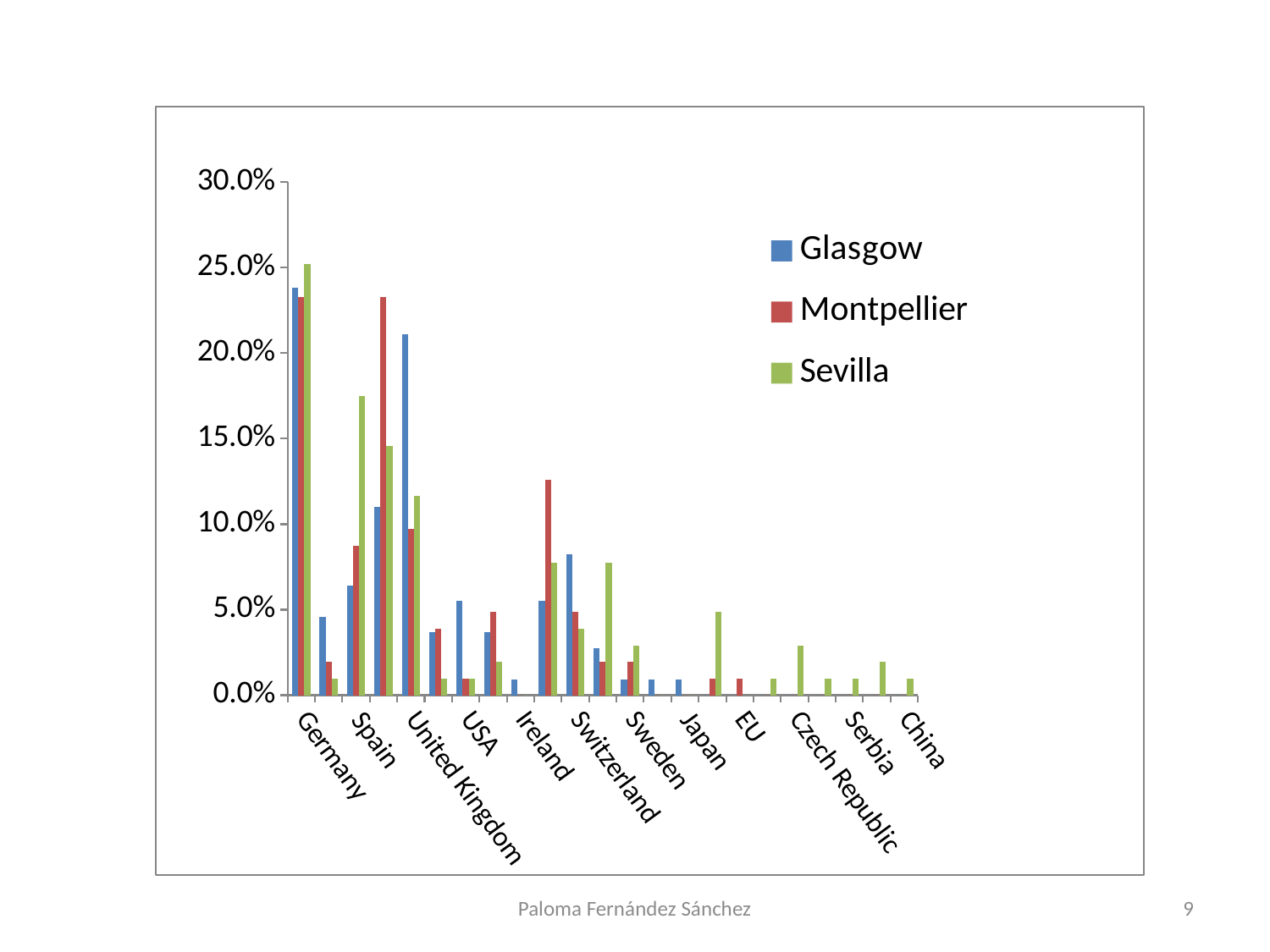
Is the Montpellier value for Germany greater or less than 20.0%? greater Which colour represents the Sevilla series? green For United Kingdom, which is larger: the Glasgow value or the Montpellier value? Glasgow Which country has the highest Sevilla value? Germany Is the Sevilla value for Spain greater or less than 15.0%? greater Is the Glasgow value for Germany greater or less than 25.0%? less For Switzerland, which series has the highest value? Glasgow What kind of chart is shown on the slide? bar chart Which series are listed in the legend? Glasgow, Montpellier, Sevilla For Spain, which series has the highest value? Sevilla How many series does the legend list? 3